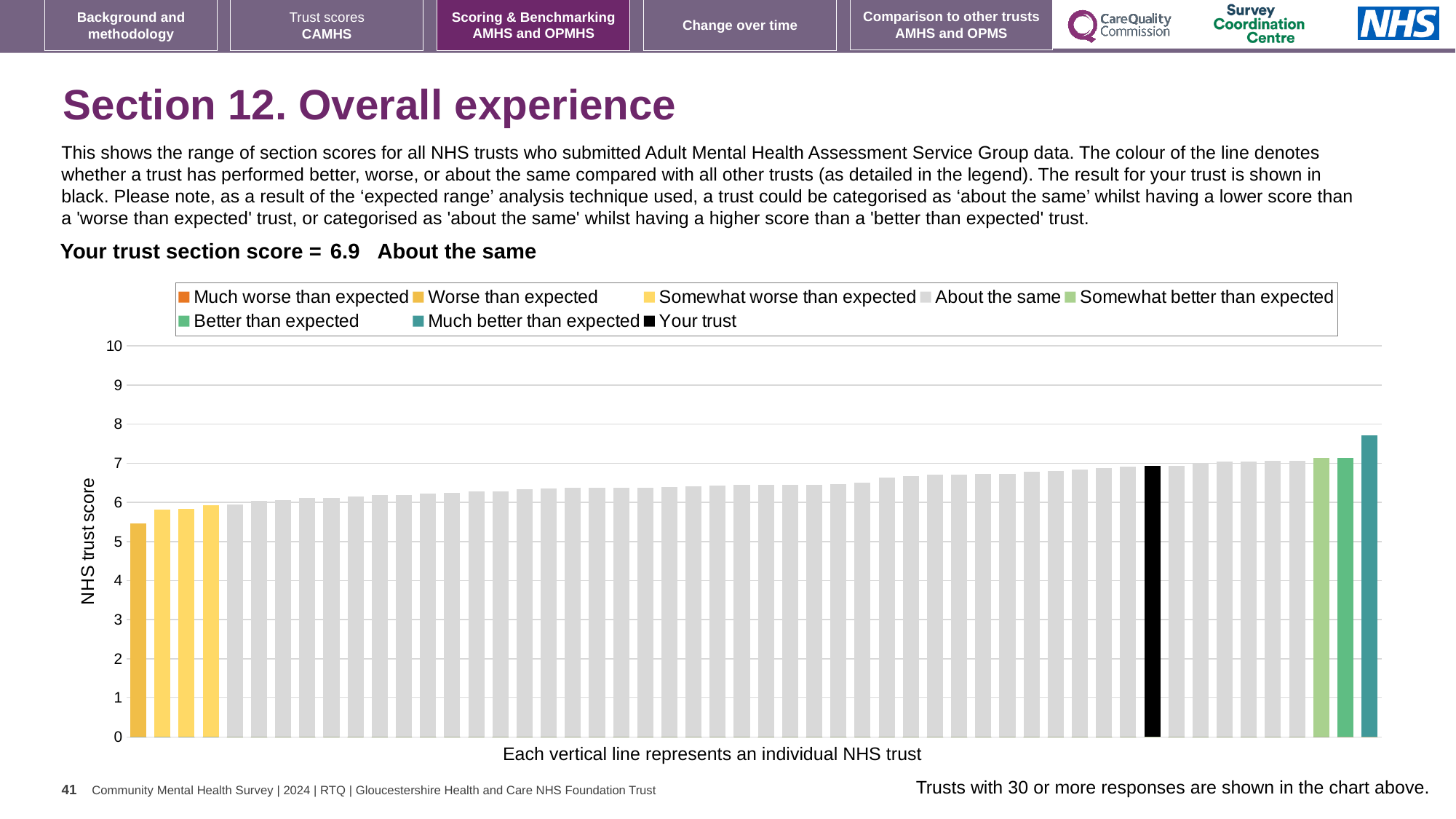
How many entries does the chart legend list? 8 What is the section score for your trust shown on the slide? 6.9 Is the value of the lowest bar in the chart greater or less than 6? less Is the value of the tallest bar in the chart greater or less than 7? greater Is the value of the black 'Your trust' bar greater or less than 6? greater Which legend category does the shortest bar in the chart belong to? Worse than expected Do the bar values rise or fall from left to right along the x axis? rise How many bars are coloured teal (Much better than expected)? 1 What is the label on the vertical axis of the chart? NHS trust score What kind of chart is shown on the slide? bar chart Which performance category is your trust placed in according to the slide? About the same Which legend category does the tallest bar in the chart belong to? Much better than expected